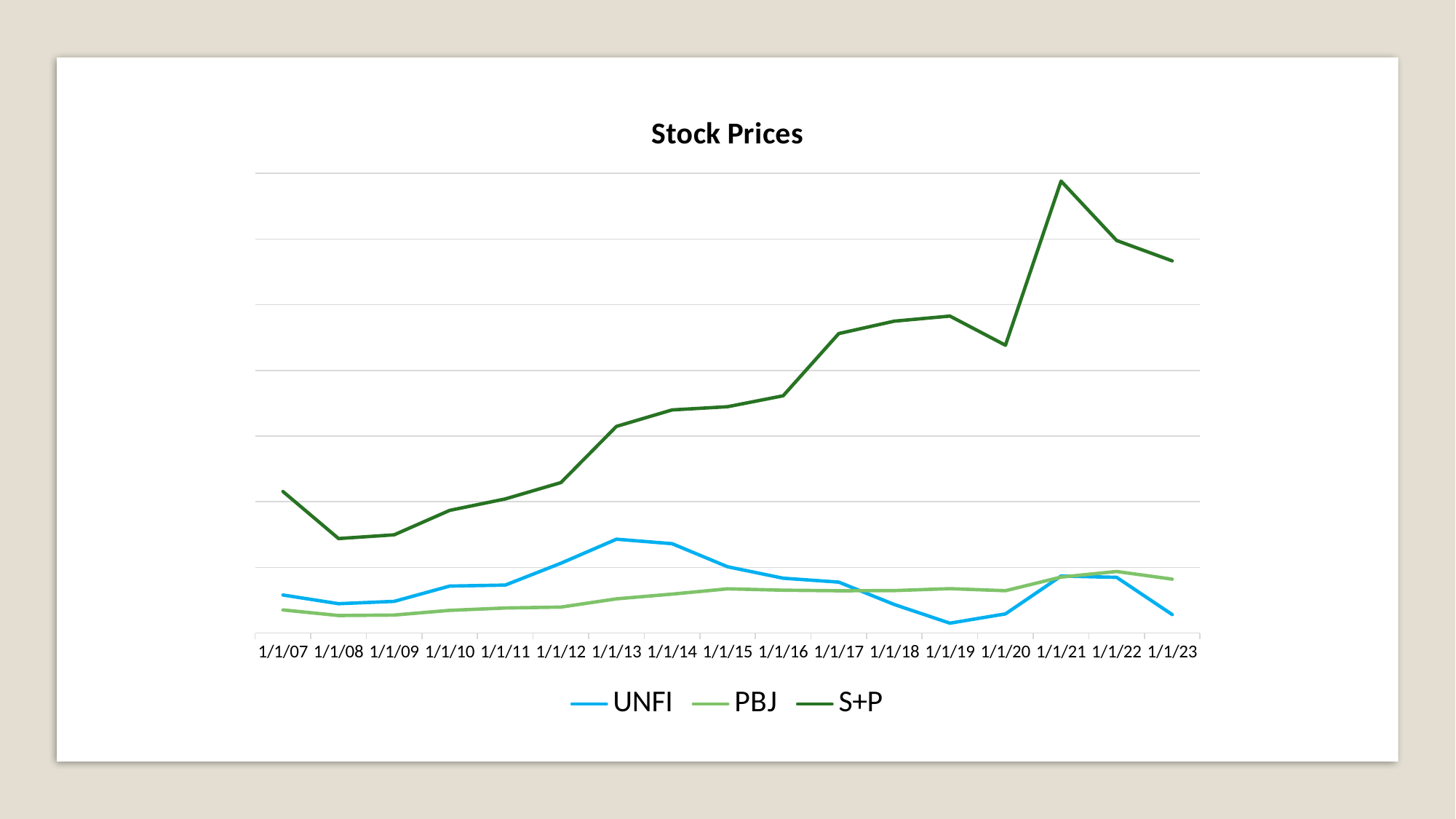
How many dates are shown along the x axis? 17 What is the title of the chart? Stock Prices At 1/1/23, which is higher, UNFI or PBJ? PBJ On which date is the UNFI series at its lowest value? 1/1/19 What kind of chart is shown on the slide? line chart At 1/1/13, which is higher, UNFI or PBJ? UNFI Does the S+P series rise or fall from 1/1/20 to 1/1/21? rise On which date does the S+P series reach its highest value? 1/1/21 Which series has the highest values across the whole period? S+P Which series are listed in the legend? UNFI, PBJ, S+P Does the UNFI series rise or fall from 1/1/22 to 1/1/23? fall How many series does the legend list? 3